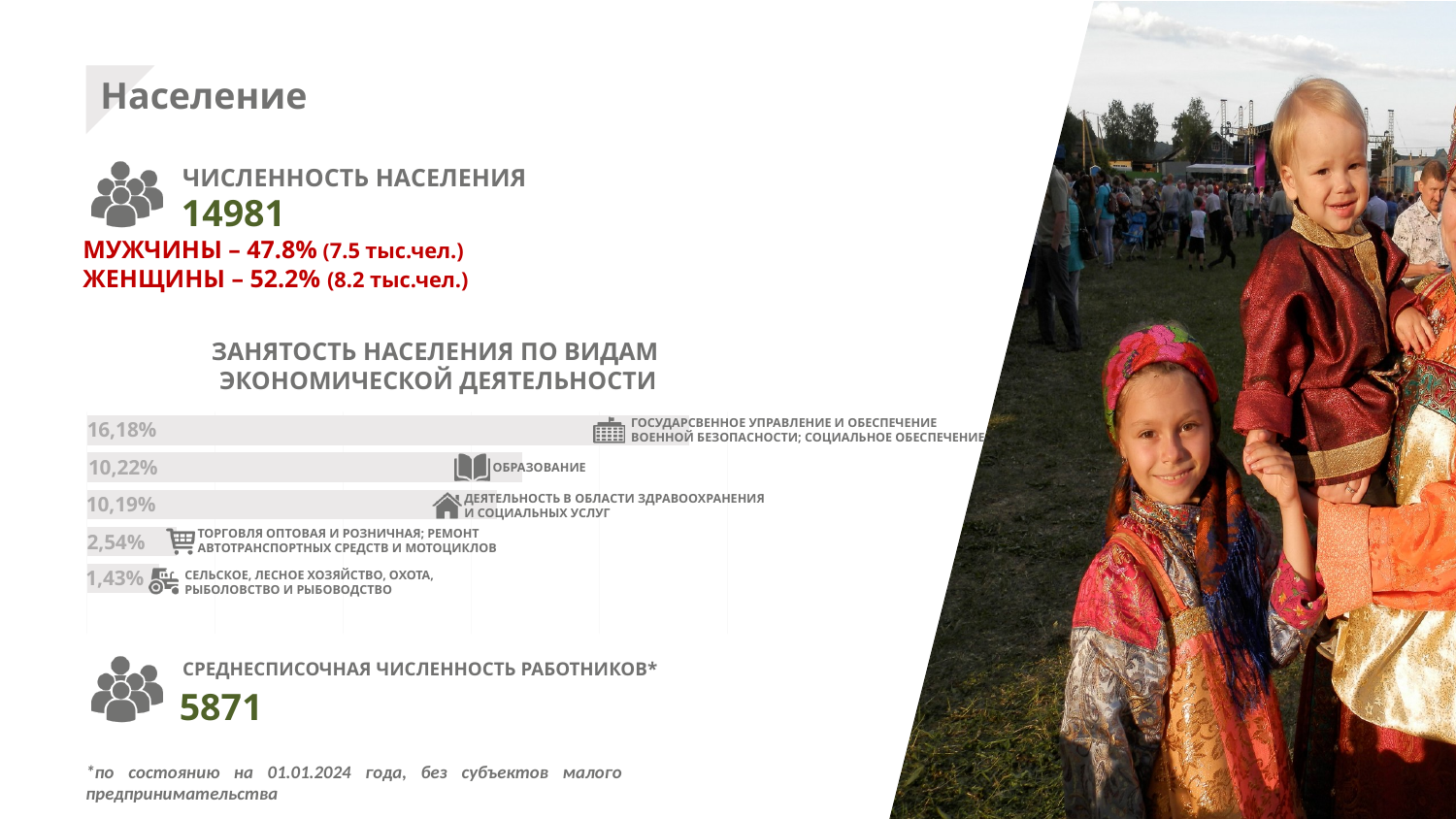
What is the difference between the values for ОБРАЗОВАНИЕ and ДЕЯТЕЛЬНОСТЬ В ОБЛАСТИ ЗДРАВООХРАНЕНИЯ И СОЦИАЛЬНЫХ УСЛУГ in the employment chart? 0,03% Which is larger in the employment chart: the value for ТОРГОВЛЯ ОПТОВАЯ И РОЗНИЧНАЯ or the value for СЕЛЬСКОЕ, ЛЕСНОЕ ХОЗЯЙСТВО? ТОРГОВЛЯ ОПТОВАЯ И РОЗНИЧНАЯ What is the title of the bar chart on the slide? ЗАНЯТОСТЬ НАСЕЛЕНИЯ ПО ВИДАМ ЭКОНОМИЧЕСКОЙ ДЕЯТЕЛЬНОСТИ What is the value for ГОСУДАРСТВЕННОЕ УПРАВЛЕНИЕ И ОБЕСПЕЧЕНИЕ ВОЕННОЙ БЕЗОПАСНОСТИ; СОЦИАЛЬНОЕ ОБЕСПЕЧЕНИЕ in the employment chart? 16,18% What is the value for ОБРАЗОВАНИЕ in the employment chart? 10,22% What is the difference between the values for ГОСУДАРСТВЕННОЕ УПРАВЛЕНИЕ and ОБРАЗОВАНИЕ in the employment chart? 5,96% Which category has the lowest share in the employment chart? СЕЛЬСКОЕ, ЛЕСНОЕ ХОЗЯЙСТВО, ОХОТА, РЫБОЛОВСТВО И РЫБОВОДСТВО What is the value for ТОРГОВЛЯ ОПТОВАЯ И РОЗНИЧНАЯ; РЕМОНТ АВТОТРАНСПОРТНЫХ СРЕДСТВ И МОТОЦИКЛОВ in the employment chart? 2,54% What is the value for СЕЛЬСКОЕ, ЛЕСНОЕ ХОЗЯЙСТВО, ОХОТА, РЫБОЛОВСТВО И РЫБОВОДСТВО in the employment chart? 1,43% How many categories of economic activity are shown in the employment chart? 5 What type of chart is used to show employment by type of economic activity? bar chart Which category has the highest share in the employment chart? ГОСУДАРСТВЕННОЕ УПРАВЛЕНИЕ И ОБЕСПЕЧЕНИЕ ВОЕННОЙ БЕЗОПАСНОСТИ; СОЦИАЛЬНОЕ ОБЕСПЕЧЕНИЕ